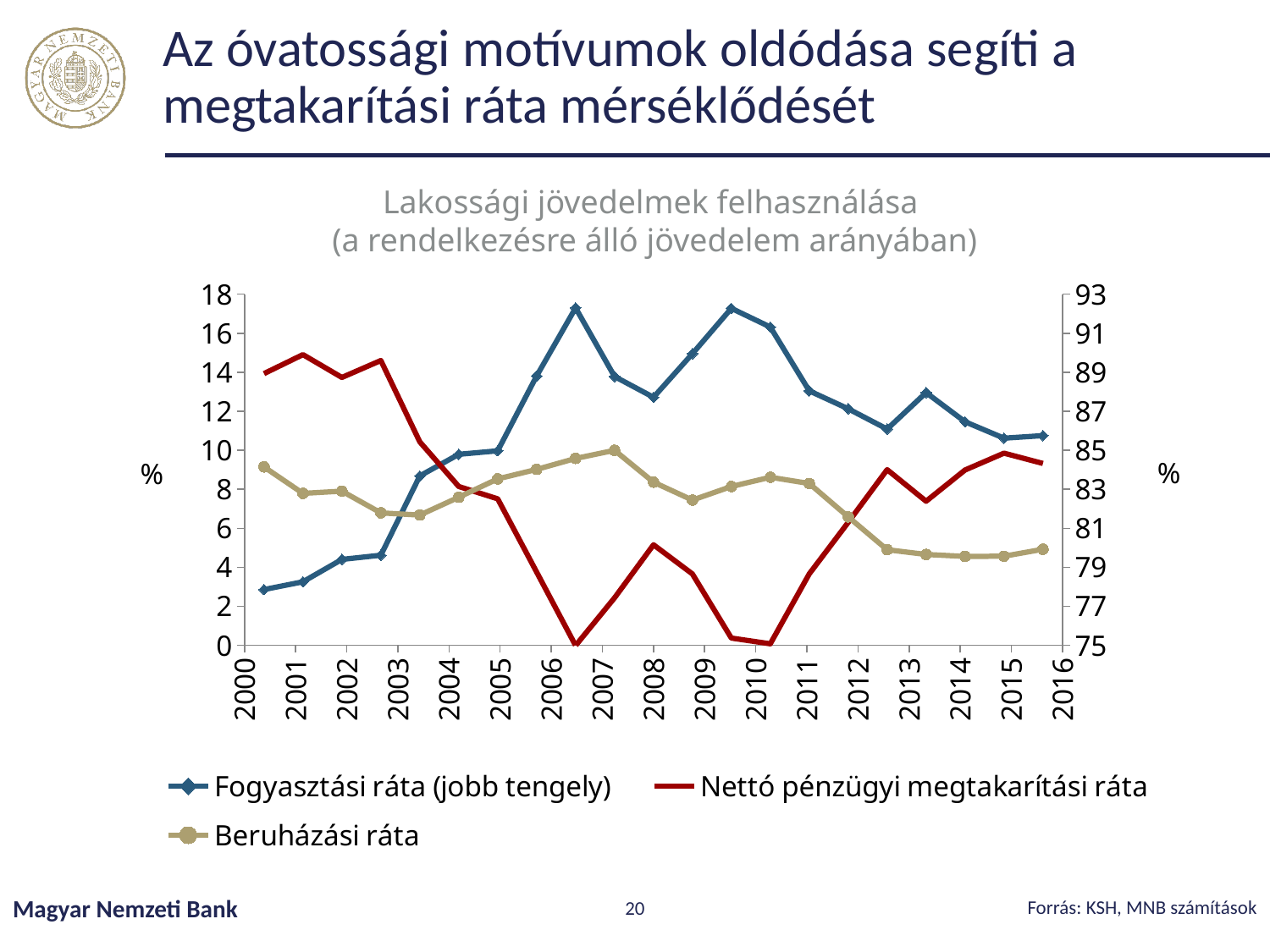
In 2013, which is higher: Nettó pénzügyi megtakarítási ráta or Beruházási ráta? Nettó pénzügyi megtakarítási ráta Is the value for Beruházási ráta in 2014 greater or less than 6? less What kind of chart is shown on the slide? Line chart Is the value for Nettó pénzügyi megtakarítási ráta in 2000 greater or less than 12? greater How many series does the legend list? 3 Which series is plotted on the right axis according to the legend? Fogyasztási ráta (jobb tengely) What is the title of the chart? Lakossági jövedelmek felhasználása (a rendelkezésre álló jövedelem arányában) Does Nettó pénzügyi megtakarítási ráta rise or fall between 2010 and 2015? rise Does Beruházási ráta rise or fall between 2007 and 2013? fall In which year does Beruházási ráta reach its highest value? 2007